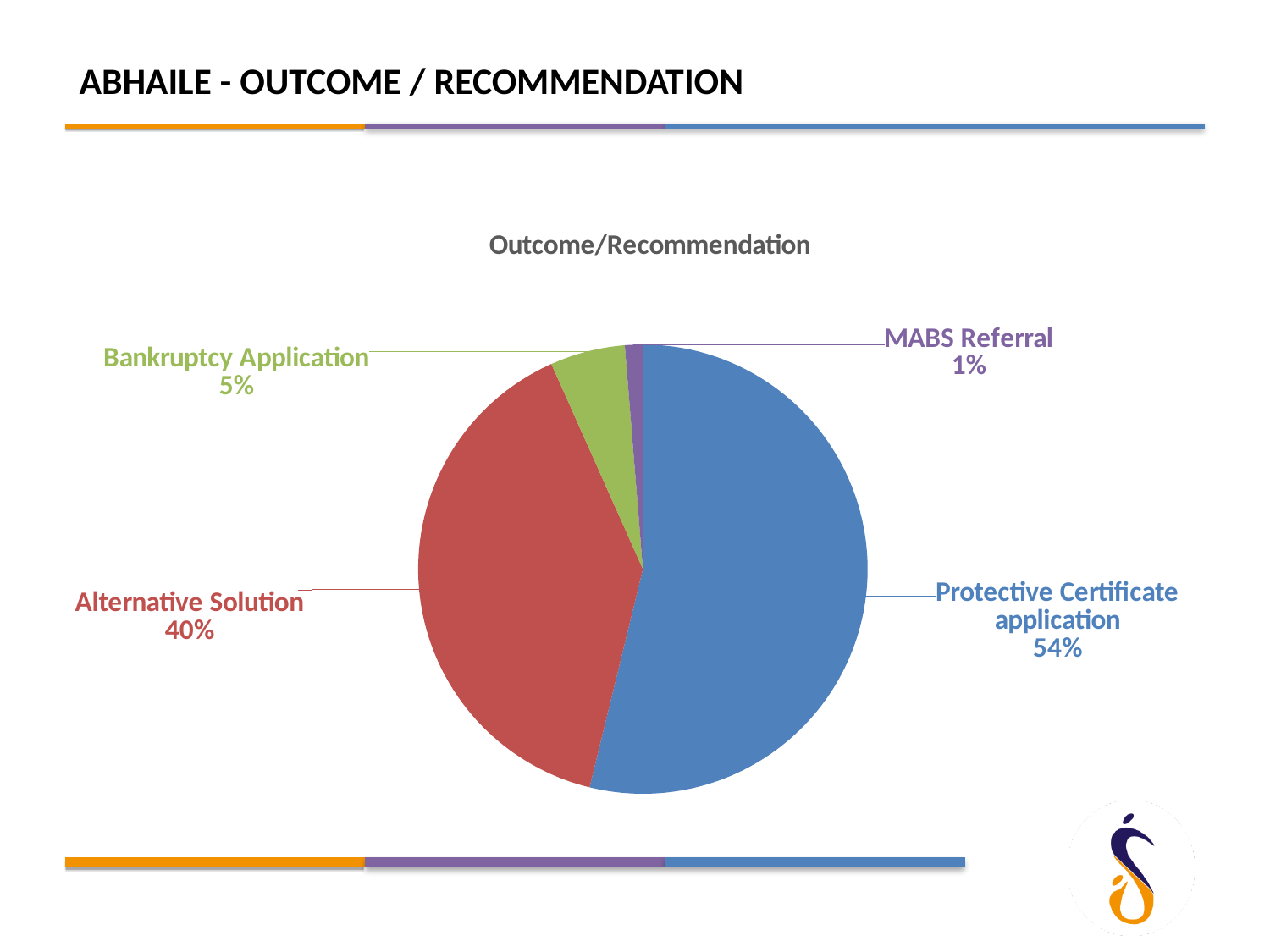
Which is larger, Bankruptcy Application or MABS Referral? Bankruptcy Application What colour is the Alternative Solution slice? red Which category has the largest slice of the pie? Protective Certificate application What kind of chart is shown on the slide? pie chart What share of the pie is Protective Certificate application? 54% Which category has the smallest slice of the pie? MABS Referral What share of the pie is Alternative Solution? 40% What is the difference in percentage points between Protective Certificate application and Alternative Solution? 14 What is the title of the chart? Outcome/Recommendation What share of the pie is MABS Referral? 1% How many categories are shown in the pie chart? 4